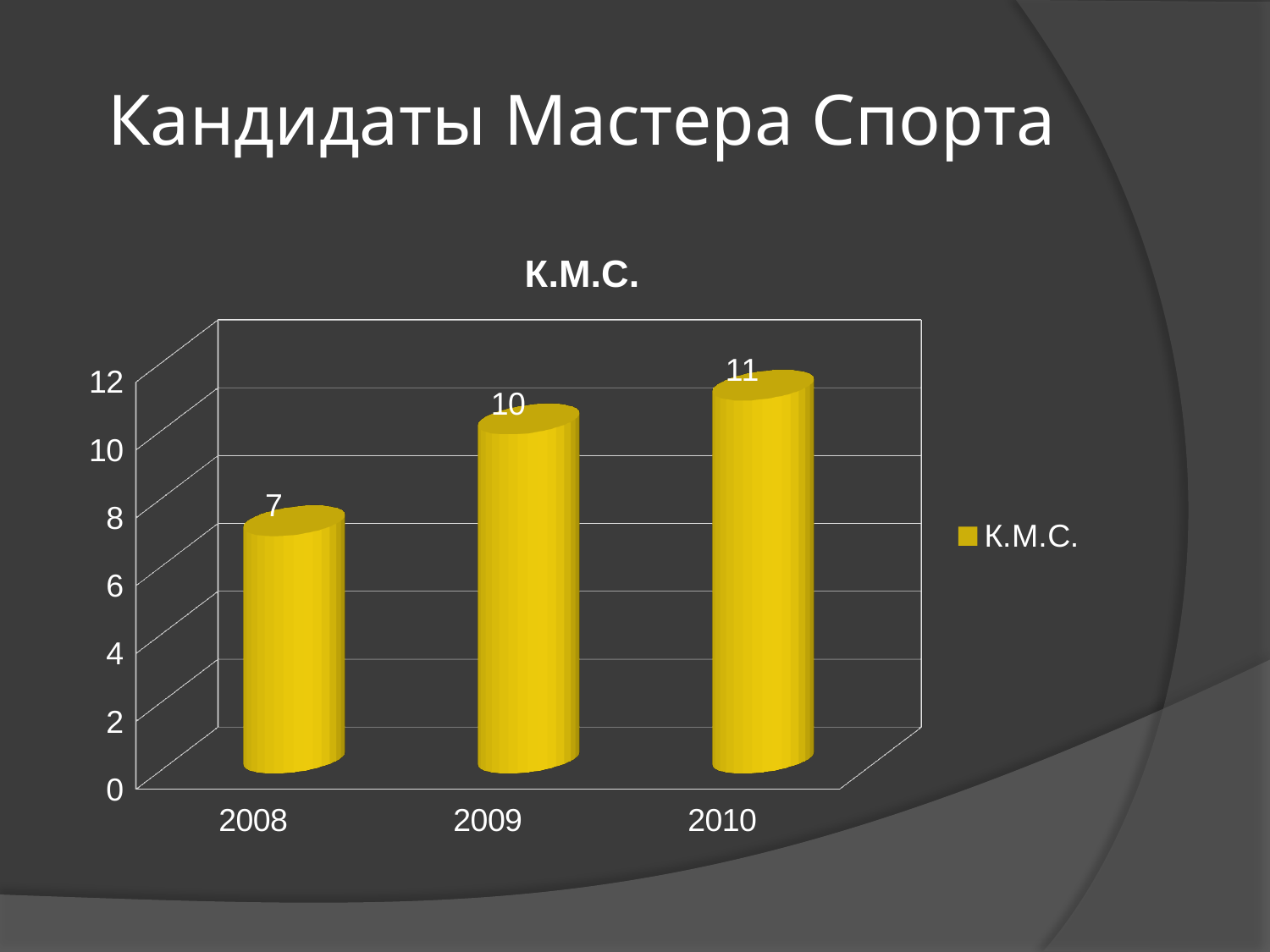
Which is larger, the value for 2009 or the value for 2008? 2009 What is the value for 2010? 11 What kind of chart is shown? bar chart What is the value for 2008? 7 Which year has the lowest value? 2008 What is the difference between the values for 2009 and 2008? 3 Which year has the highest value? 2010 What is the difference between the values for 2010 and 2008? 4 How many years are shown on the x axis? 3 How many series does the legend list? 1 Do the values rise or fall from 2008 to 2010? rise What is the value for 2009? 10